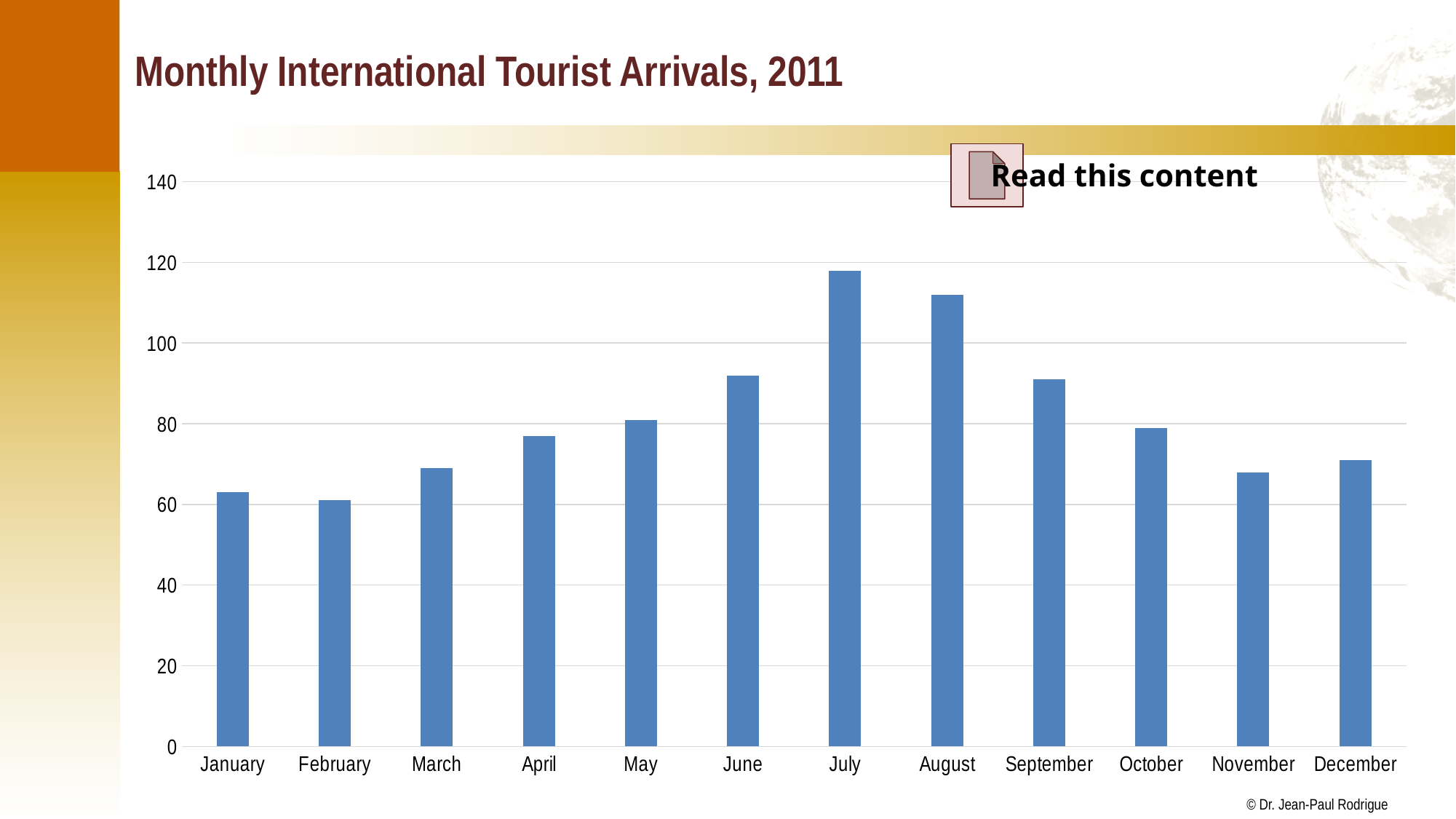
What kind of chart is shown on the slide? bar chart What is the title of the chart? Monthly International Tourist Arrivals, 2011 Is the value for November greater or less than 60? greater Do the values rise or fall from January to July? rise Which month has the highest value in the chart? July Is the value for February greater or less than 80? less Is the value for June greater or less than 100? less Which is larger, the value for June or the value for May? June Which is larger, the value for December or the value for September? September How many months are shown on the x axis of the chart? 12